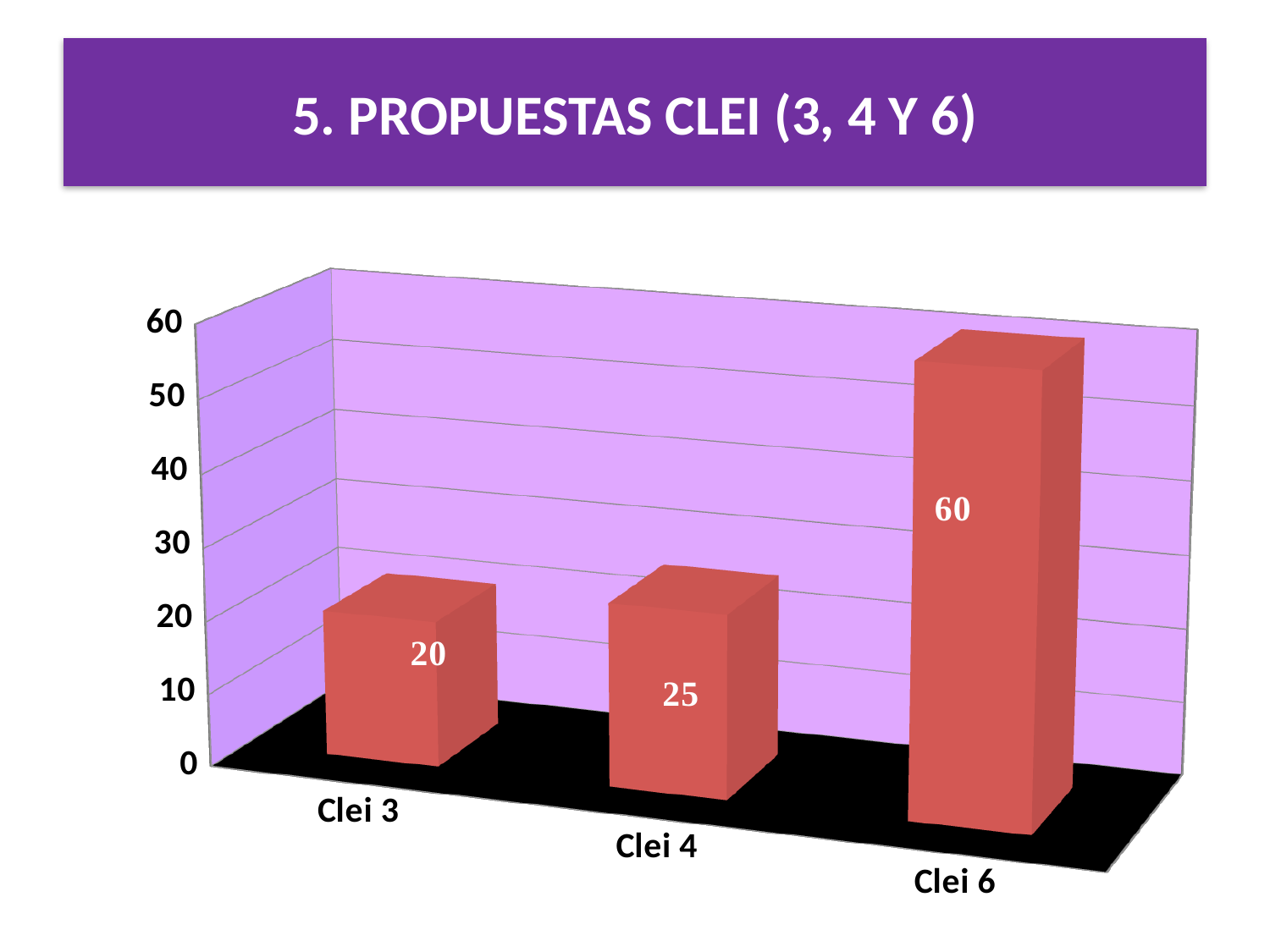
How many categories are shown in the chart? 3 Which is larger, the value for Clei 4 or the value for Clei 3? Clei 4 Do the values rise or fall from Clei 3 to Clei 6? rise What is the value for Clei 6? 60 Which category has the highest value? Clei 6 What kind of chart is shown on the slide? bar chart Which category has the lowest value? Clei 3 What is the value for Clei 3? 20 Is the value for Clei 6 greater or less than 40? greater What is the difference between the values for Clei 6 and Clei 4? 35 What is the value for Clei 4? 25 What is the difference between the values for Clei 4 and Clei 3? 5